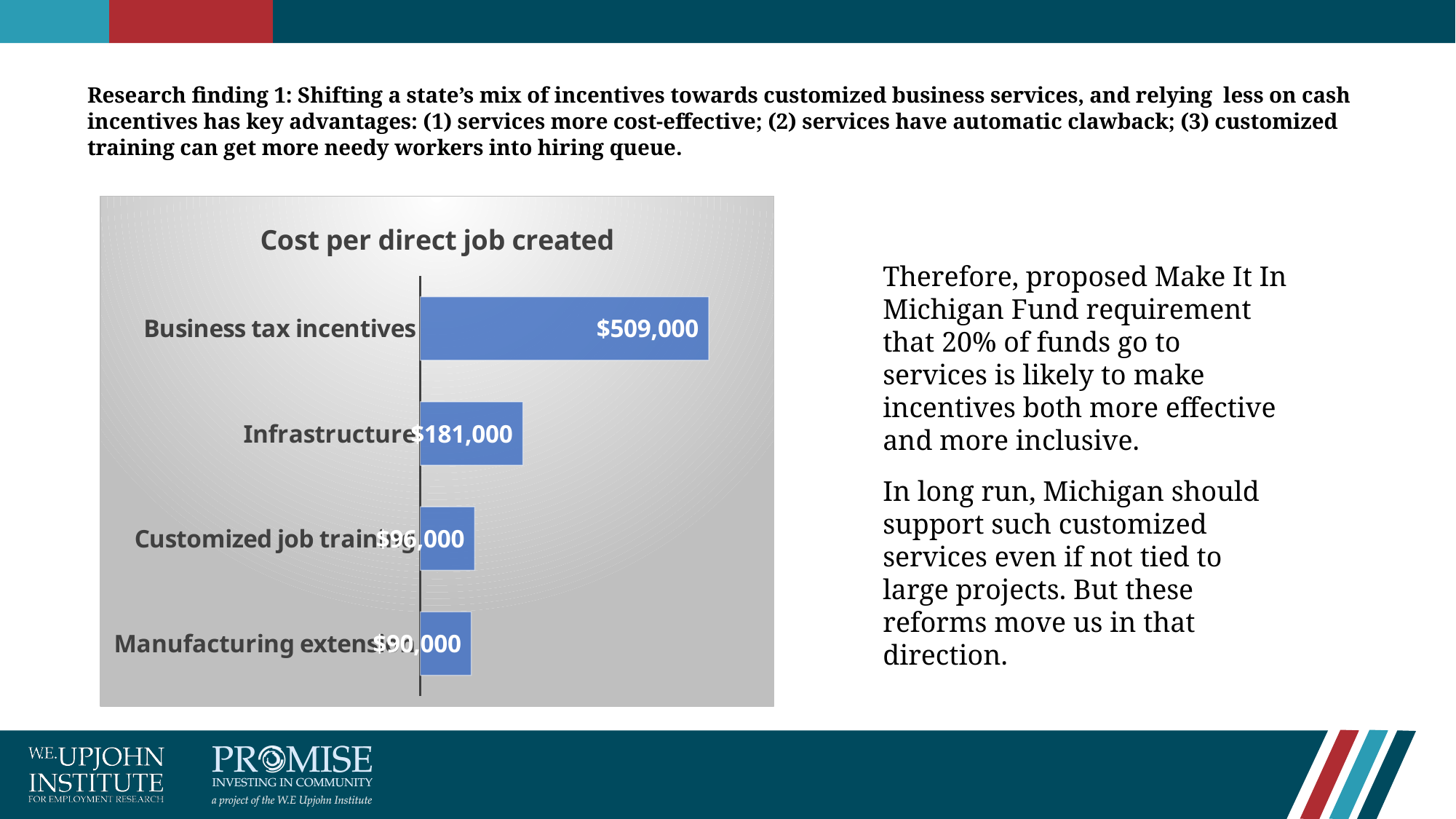
Which category has the highest cost per direct job created? Business tax incentives What is the difference in cost per direct job created between Business tax incentives and Infrastructure? $328,000 What is the cost per direct job created for Manufacturing extension? $90,000 What is the cost per direct job created for Customized job training? $96,000 How many categories are shown in the chart? 4 What is the title of the chart? Cost per direct job created What is the cost per direct job created for Business tax incentives? $509,000 What is the cost per direct job created for Infrastructure? $181,000 Which category has the lowest cost per direct job created? Manufacturing extension Which has a higher cost per direct job created, Infrastructure or Customized job training? Infrastructure What is the difference in cost per direct job created between Infrastructure and Customized job training? $85,000 What kind of chart is shown on the slide? Bar chart